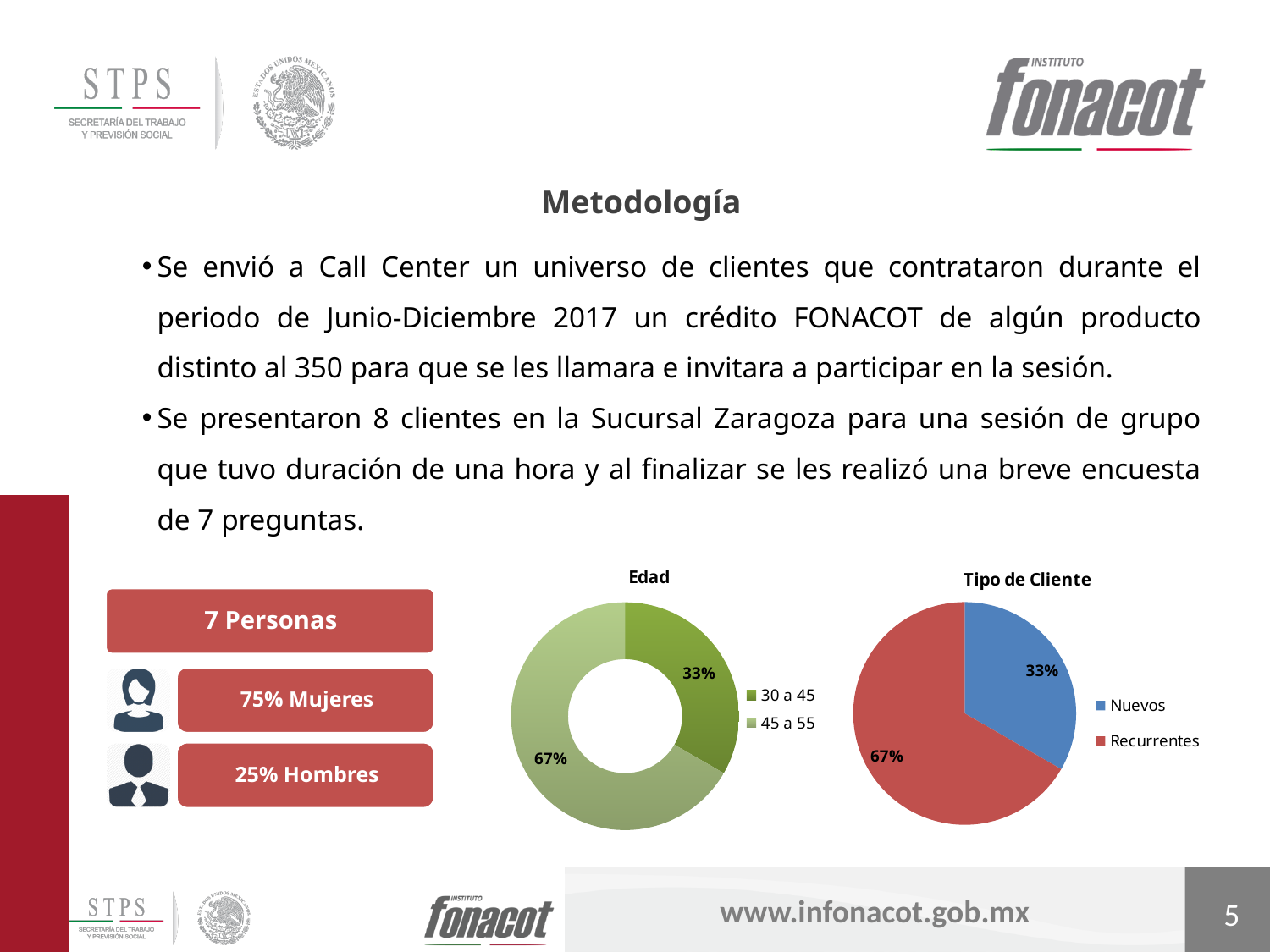
In the 'Tipo de Cliente' chart, what percentage is shown for 'Recurrentes'? 67% How many categories does the legend of the 'Edad' chart list? 2 What is the title of the chart on the right side of the slide? Tipo de Cliente What kind of chart is the 'Tipo de Cliente' chart? Pie chart In the 'Edad' chart, what share is shown for the '30 a 45' group? 33% In the 'Edad' chart, which age group has the largest share? 45 a 55 In the 'Tipo de Cliente' chart, what percentage is shown for 'Nuevos'? 33% In the 'Tipo de Cliente' chart, which category has the smallest share? Nuevos In the 'Edad' chart, what share is shown for the '45 a 55' group? 67% In the 'Edad' chart, which is larger: the share for '30 a 45' or for '45 a 55'? 45 a 55 In the 'Tipo de Cliente' chart, what is the difference in percentage points between 'Recurrentes' and 'Nuevos'? 34 How many categories does the legend of the 'Tipo de Cliente' chart list? 2